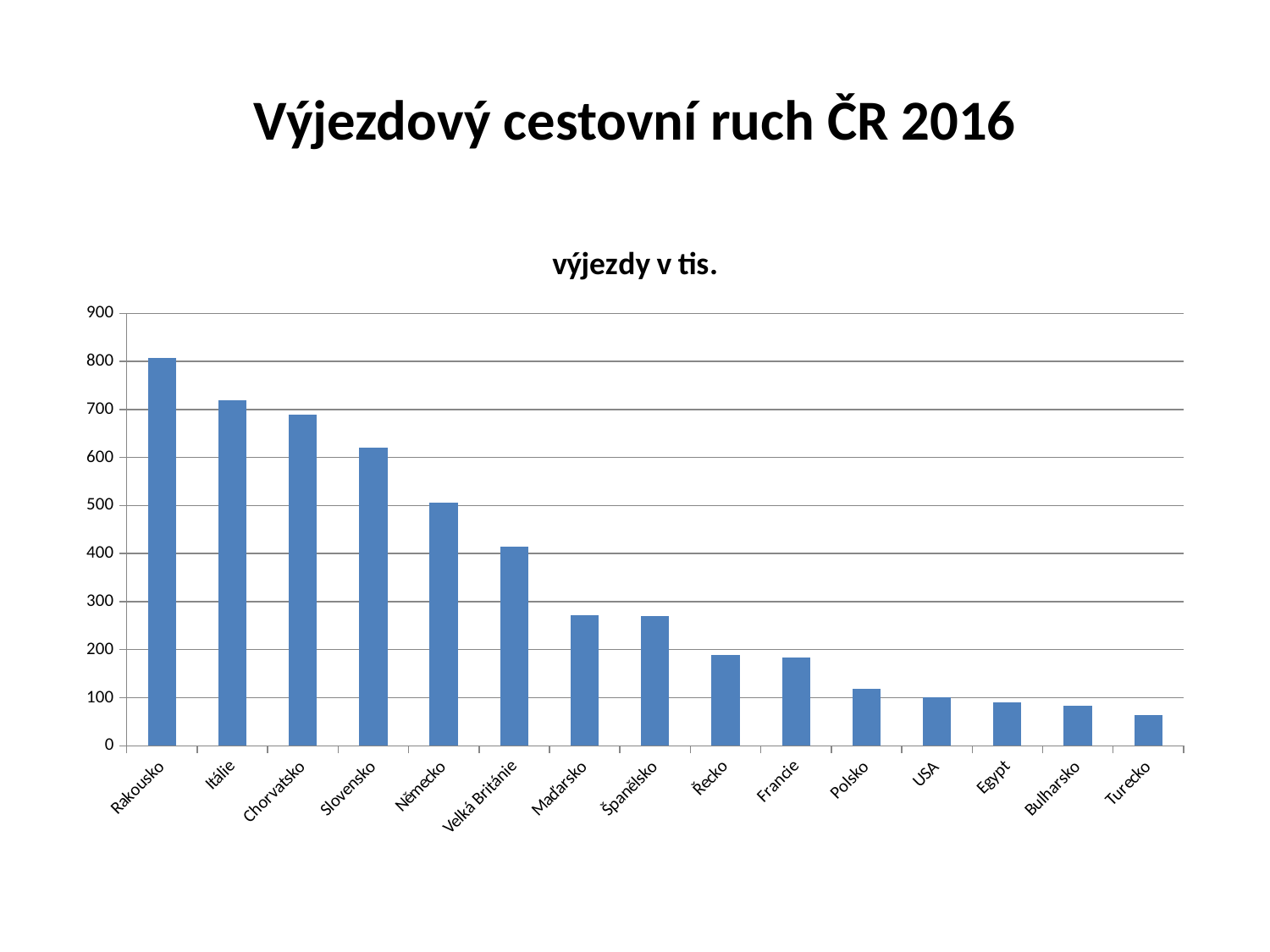
Is the value for Turecko greater or less than 100? less Do the values rise or fall from left to right along the x axis? fall Is the value for Německo greater or less than 600? less Which country has the lowest value in the chart? Turecko Which has a larger value, Chorvatsko or Slovensko? Chorvatsko Is the value for Slovensko greater or less than 600? greater Which country has the highest value in the chart? Rakousko What type of chart is shown on the slide? bar chart What is the title printed above the chart's plot area? výjezdy v tis. How many countries are shown on the x axis of the chart? 15